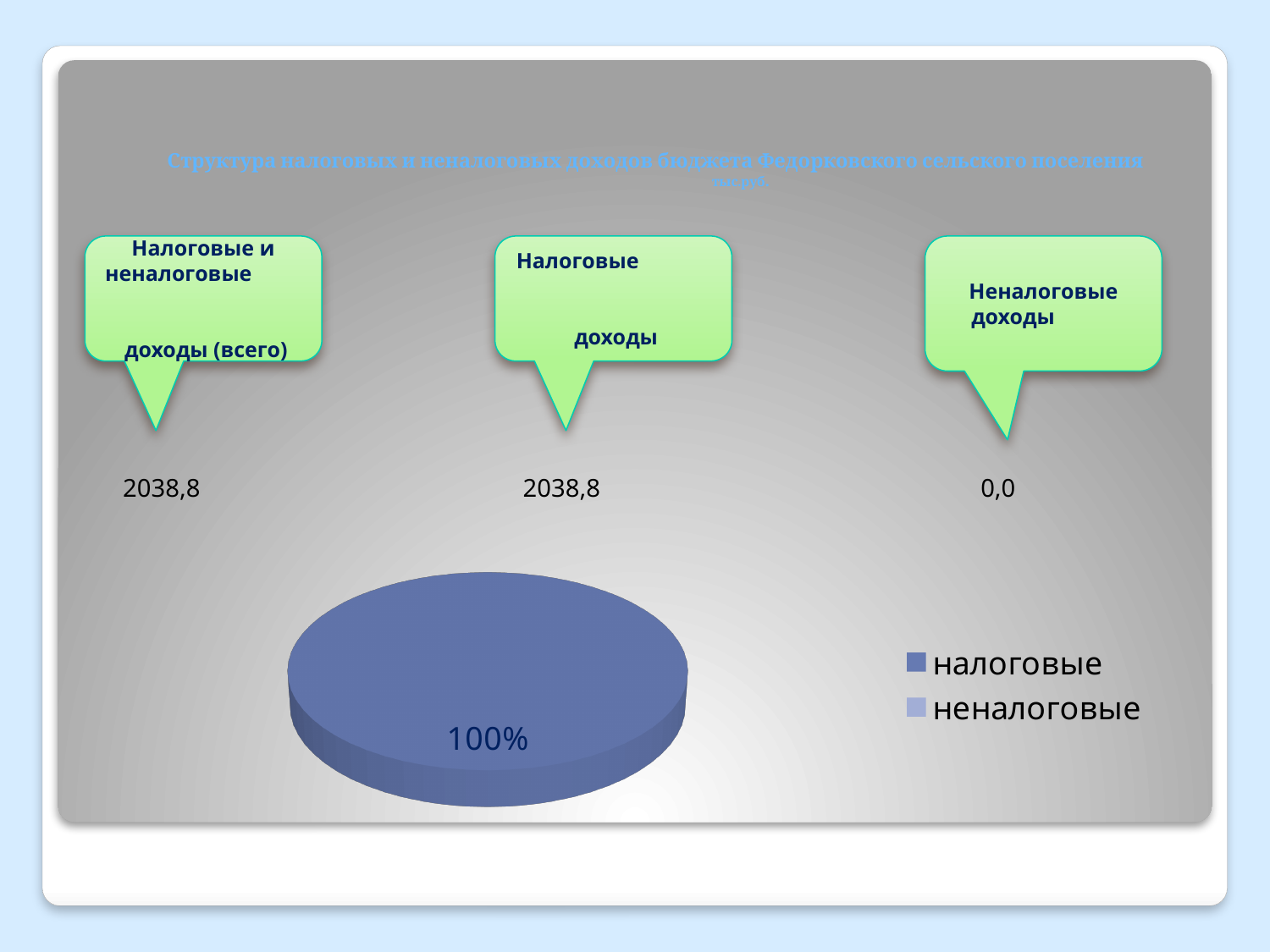
What is the first entry listed in the pie chart's legend? налоговые What share of the pie does the налоговые slice take? 100% How many entries does the legend of the pie chart list? 2 Which category has the largest share of the pie chart? налоговые What kind of chart is shown on the slide? pie chart Which is larger in the pie chart, налоговые or неналоговые? налоговые Is the share of the налоговые slice greater or less than 50%? greater Which category has the smallest share of the pie chart? неналоговые What is the second entry listed in the pie chart's legend? неналоговые What percentage label is printed on the pie chart? 100%